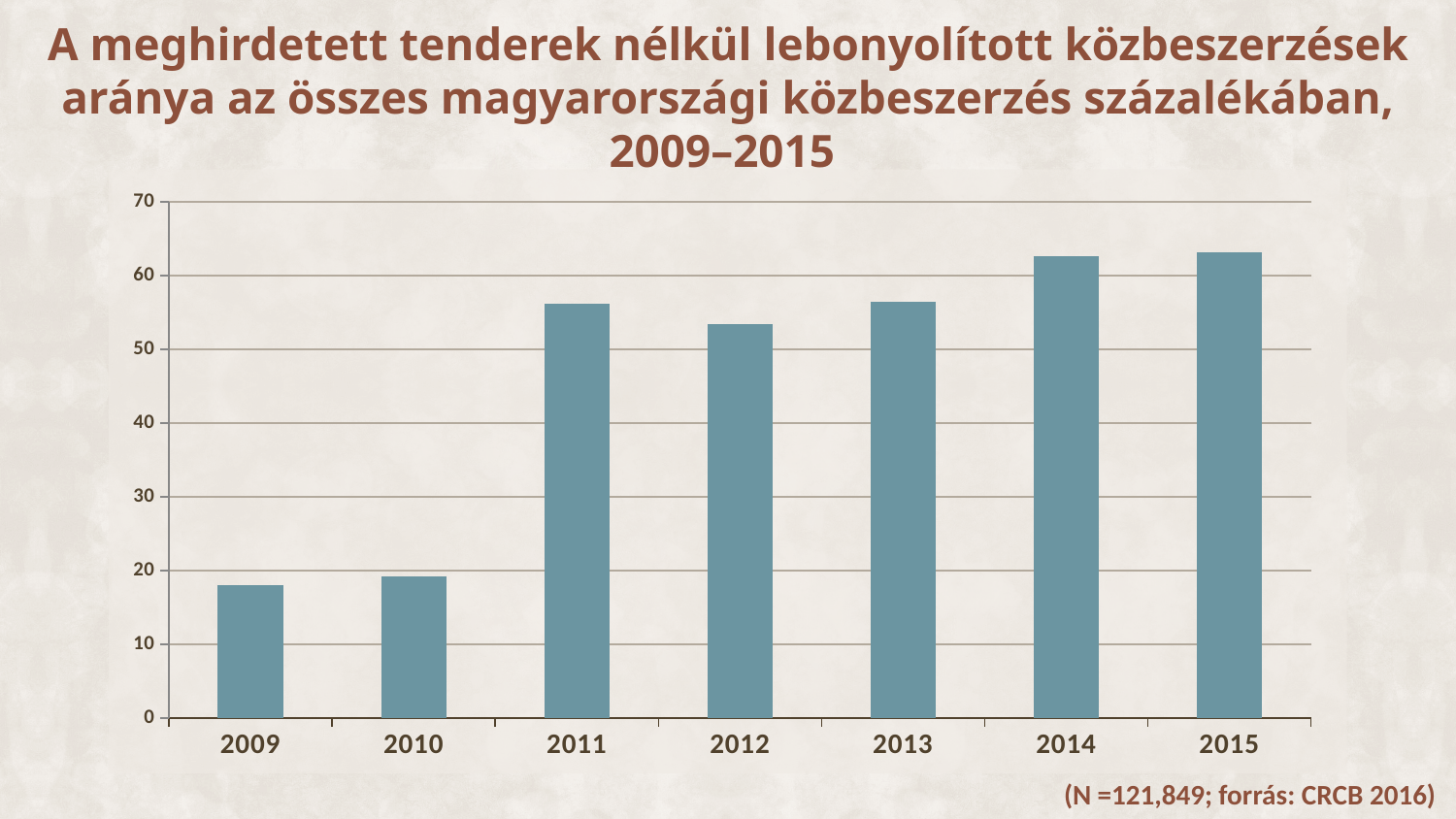
Do the values generally rise or fall from 2009 to 2015? rise Which year has the larger value, 2012 or 2014? 2014 Is the value for 2012 greater or less than 60? less How many years are shown on the x axis of the chart? 7 What kind of chart is shown on the slide? bar chart Is the value for 2011 greater or less than 50? greater Is the value for 2014 greater or less than 60? greater What sample size (N) is given in the note below the chart? 121,849 Which year has the larger value, 2010 or 2011? 2011 What is the first year shown on the x axis? 2009